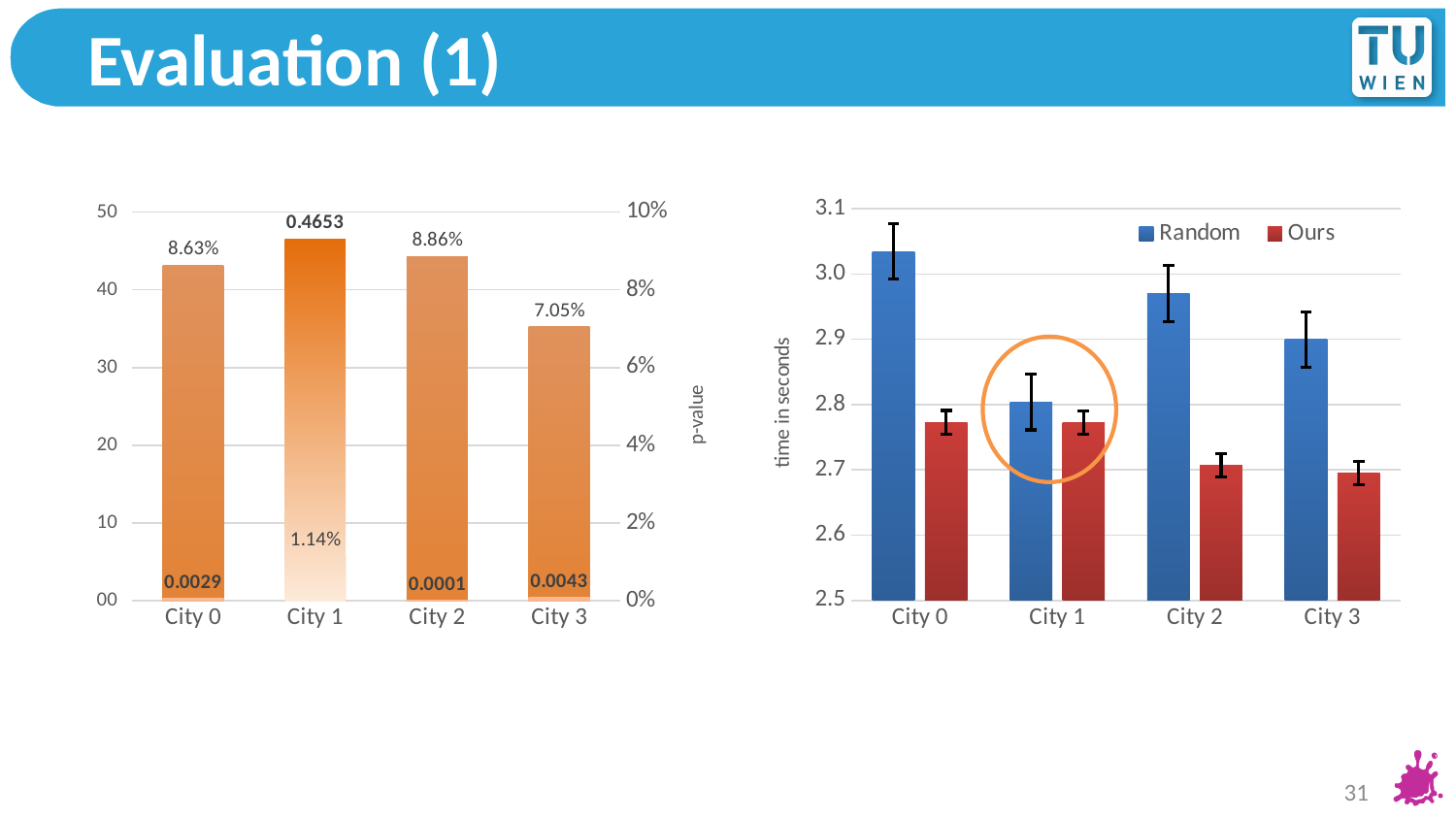
In the right chart, for City 2, which series has the larger value, Random or Ours? Random What kind of chart is the right chart? bar chart In the left chart, what percentage is labelled above the bar for City 2? 8.86% How many series does the legend of the right chart list? 2 In the right chart, is the Random value for City 0 greater or less than 3.0? greater In the left chart, what p-value is shown for City 1? 0.4653 What is the y-axis label of the right chart? time in seconds In the left chart, which city has the lowest p-value? City 2 In the left chart, which city has the highest p-value? City 1 How many cities are shown on the x axis of the left chart? 4 In the left chart, what is the difference between the percentage labels for City 2 and City 0? 0.23% In the left chart, what p-value is shown at the bottom of the City 2 bar? 0.0001